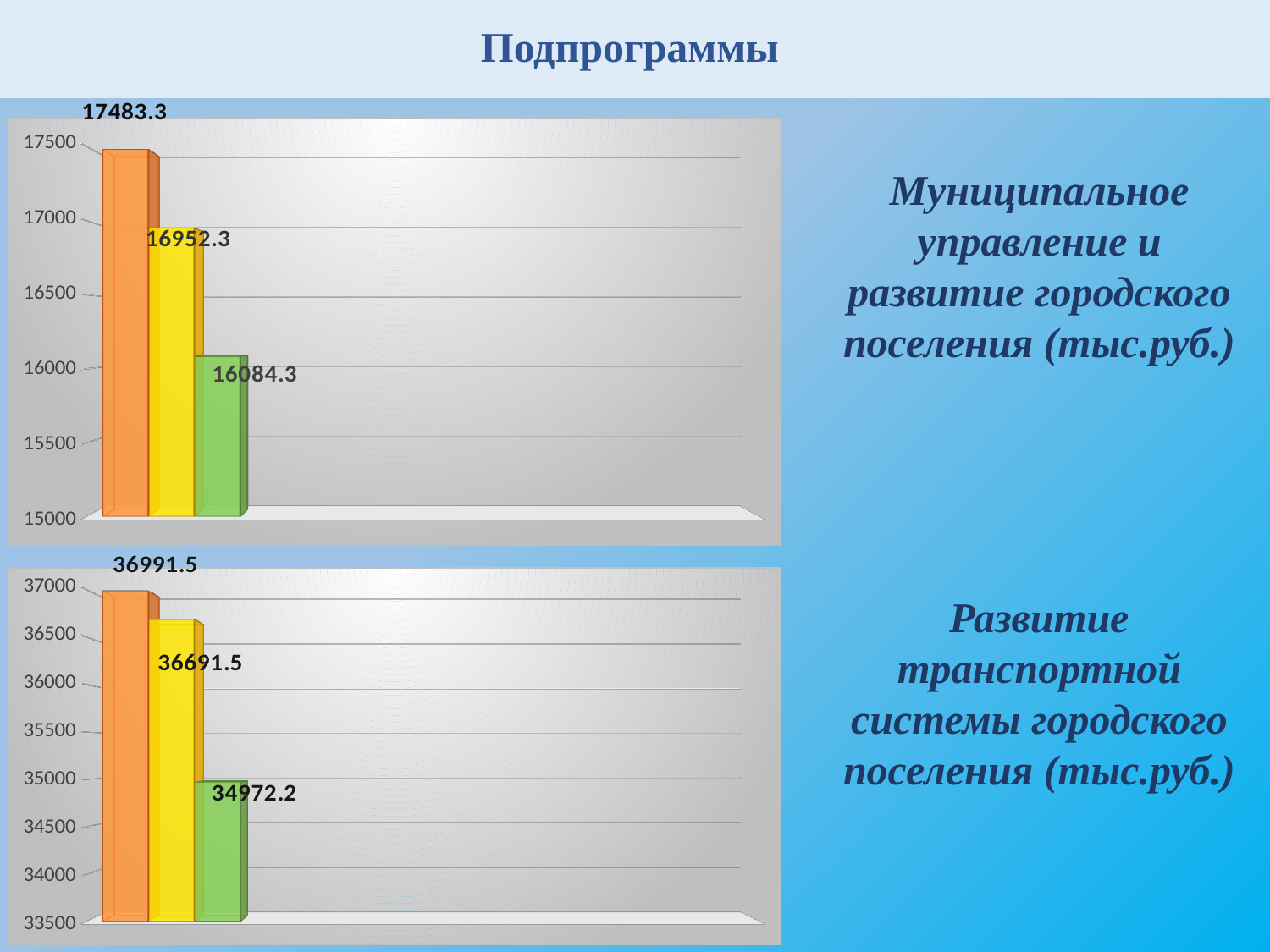
In the top chart (Муниципальное управление и развитие городского поселения), which bar has the highest value? The orange bar (17483.3) In the bottom chart (Развитие транспортной системы городского поселения), which bar has the lowest value? The green bar (34972.2) In the bottom chart (Развитие транспортной системы городского поселения), which is larger: the yellow bar or the green bar? The yellow bar In the bottom chart (Развитие транспортной системы городского поселения), what is the difference between the orange bar and the yellow bar? 300.0 In the top chart (Муниципальное управление и развитие городского поселения), do the values rise or fall from left to right? Fall How many bars are plotted in the top chart (Муниципальное управление и развитие городского поселения)? 3 In the bottom chart (Развитие транспортной системы городского поселения), what value is shown on the yellow bar? 36691.5 In the top chart (Муниципальное управление и развитие городского поселения), what is the difference between the orange bar and the green bar? 1399.0 In the top chart (Муниципальное управление и развитие городского поселения), what value is shown on the green bar? 16084.3 In the bottom chart (Развитие транспортной системы городского поселения), what value is shown on the green bar? 34972.2 What type of chart is used for Развитие транспортной системы городского поселения? Bar chart In the top chart (Муниципальное управление и развитие городского поселения), what value is shown on the orange bar? 17483.3